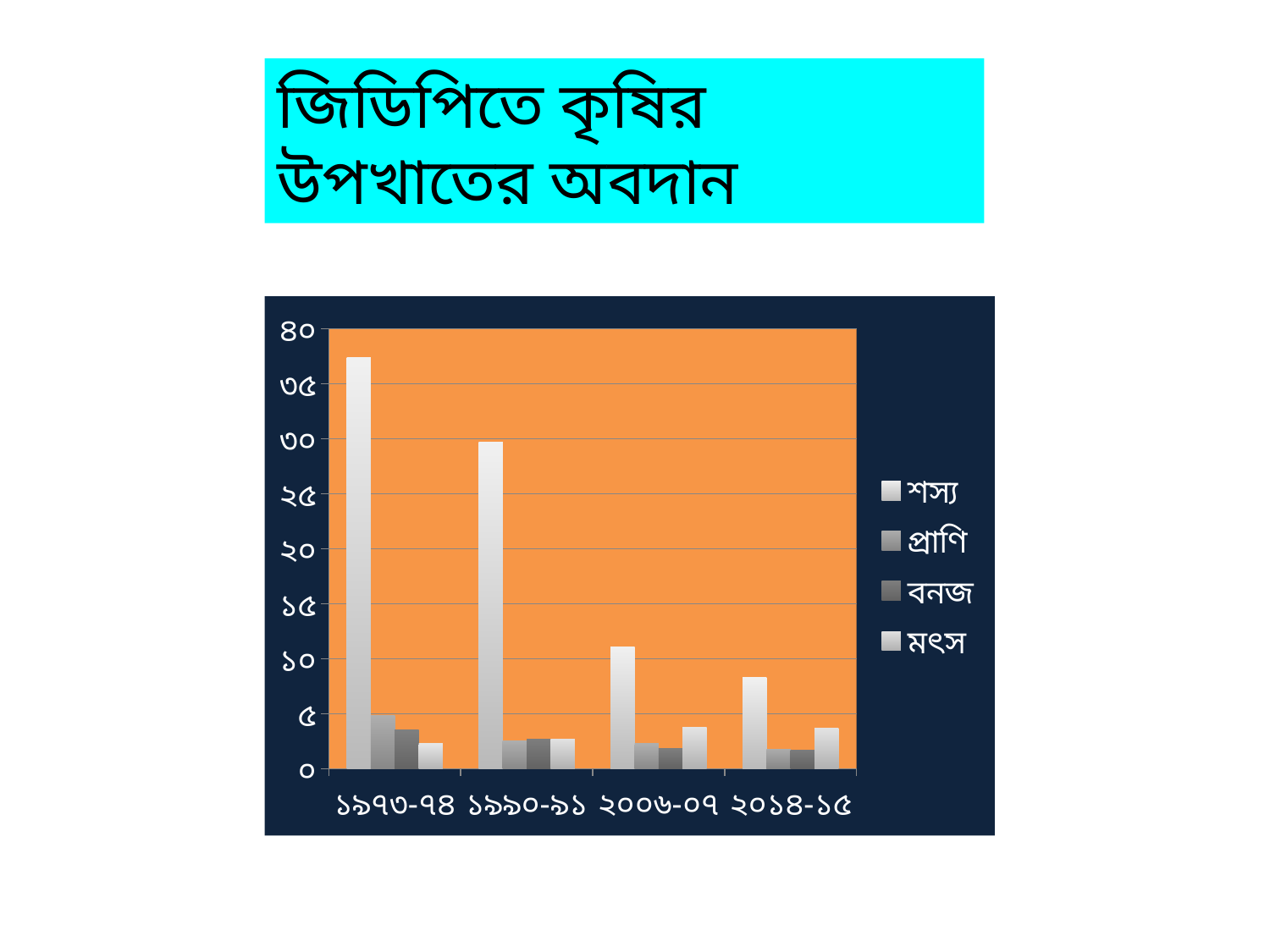
Is the value for শস্য in ১৯৯০-৯১ greater or less than ২৫? greater How many year categories are shown on the x axis of the chart? 4 In ২০১৪-১৫, which is larger: মৎস or প্রাণি? মৎস What kind of chart is shown on the slide? bar chart Which year has the lowest value for শস্য? ২০১৪-১৫ How many series does the chart's legend list? 4 Is the value for শস্য in ১৯৭৩-৭৪ greater or less than ৩৫? greater Is the value for শস্য in ২০১৪-১৫ greater or less than ১০? less In ১৯৭৩-৭৪, which is larger: প্রাণি or মৎস? প্রাণি Which year has the highest value for শস্য? ১৯৭৩-৭৪ Do the values for শস্য rise or fall from ১৯৭৩-৭৪ to ২০১৪-১৫? fall What is the title shown above the chart on the slide? জিডিপিতে কৃষির উপখাতের অবদান